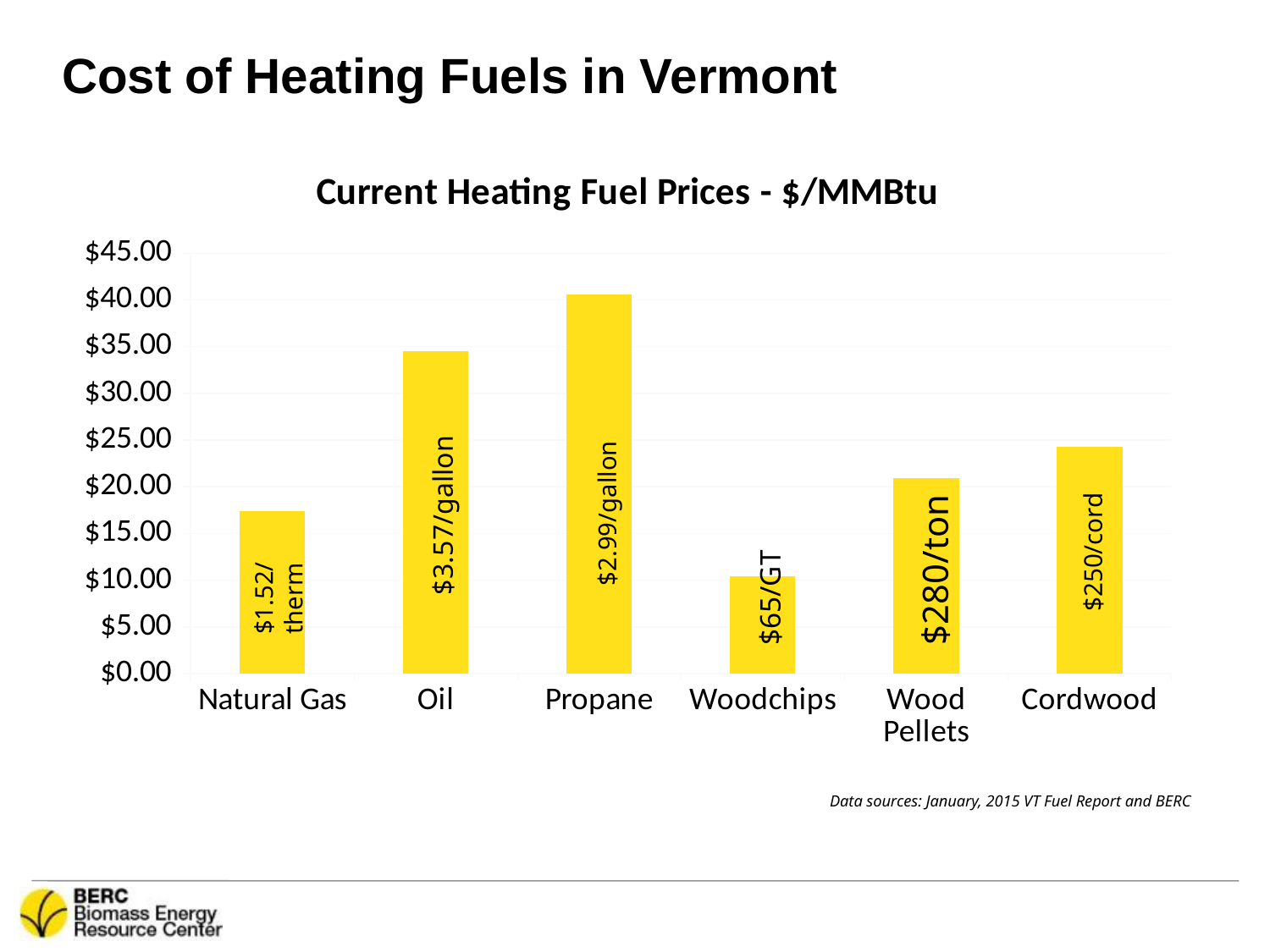
Is the value for Cordwood greater or less than $25.00? less What type of chart is shown on the slide? Bar chart Which has a higher price per MMBtu, Oil or Cordwood? Oil What is the title of the chart? Current Heating Fuel Prices - $/MMBtu Is the value for Woodchips greater or less than $15.00? less How many fuel categories are plotted in the chart? 6 What unit price label is printed inside the Wood Pellets bar? $280/ton Which fuel has the lowest price in $/MMBtu? Woodchips Which has a higher price per MMBtu, Natural Gas or Wood Pellets? Wood Pellets Is the value for Oil greater or less than $30.00? greater Which fuel has the highest price in $/MMBtu? Propane